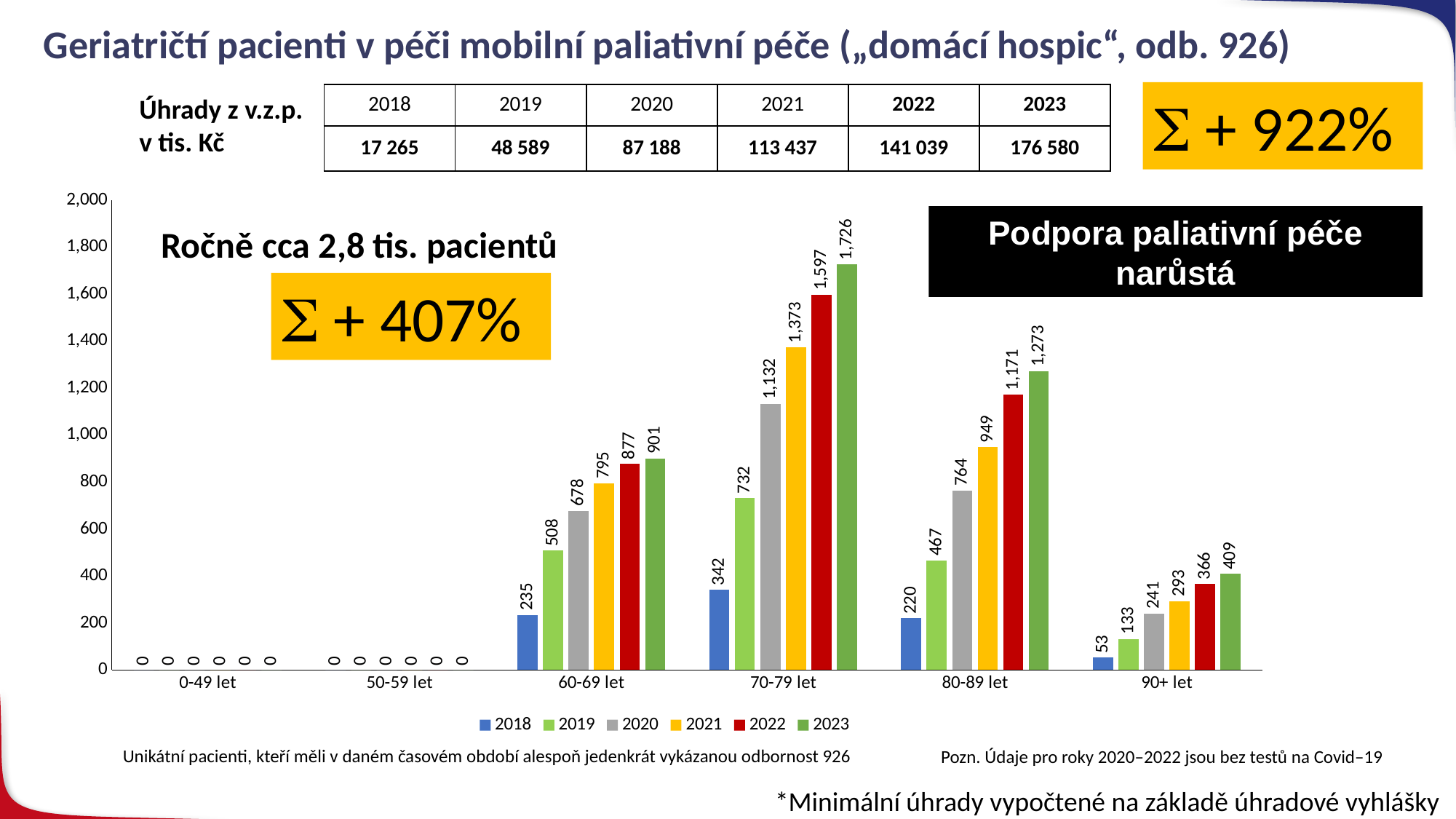
What colour are the bars for the 2022 series? red What is the value for 2021 in the 90+ let category? 293 What is the value for 2023 in the 70-79 let category? 1,726 Which age category has the highest value for 2022? 70-79 let What is the value for 2018 in the 60-69 let category? 235 What kind of chart is shown on the slide? bar chart How many age categories are shown on the x axis? 6 What is the difference between the 2023 and 2018 values in the 80-89 let category? 1,053 Within the 70-79 let category, do the values rise or fall from 2018 to 2023? rise How many series does the legend list? 6 Which is larger: the 2020 value for 60-69 let or the 2020 value for 80-89 let? 80-89 let Among the categories with non-zero values, which has the lowest value for 2019? 90+ let